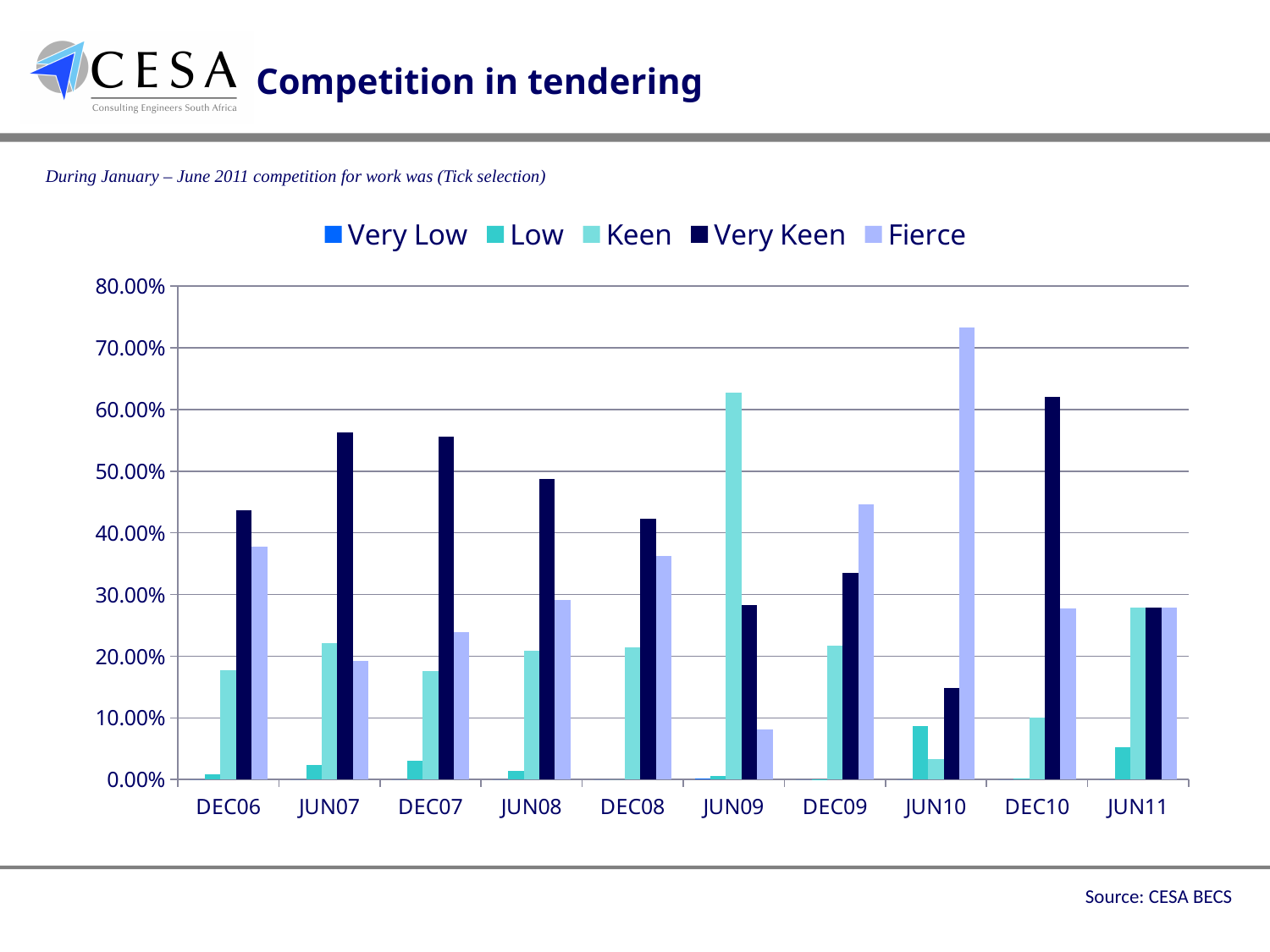
Is the Fierce value for JUN10 greater or less than 70.00%? greater Is the Keen value for JUN09 greater or less than 60.00%? greater In which period is the Very Keen bar the lowest? JUN10 How many survey periods are shown along the x axis? 10 Is the Very Keen value for JUN07 greater or less than 50.00%? greater In JUN09, which is larger: Keen or Very Keen? Keen What kind of chart is shown on the slide? bar chart In which period is the Fierce bar the highest? JUN10 In DEC09, which is larger: Fierce or Very Keen? Fierce How many series does the legend list? 5 What is the title of the slide containing the chart? Competition in tendering